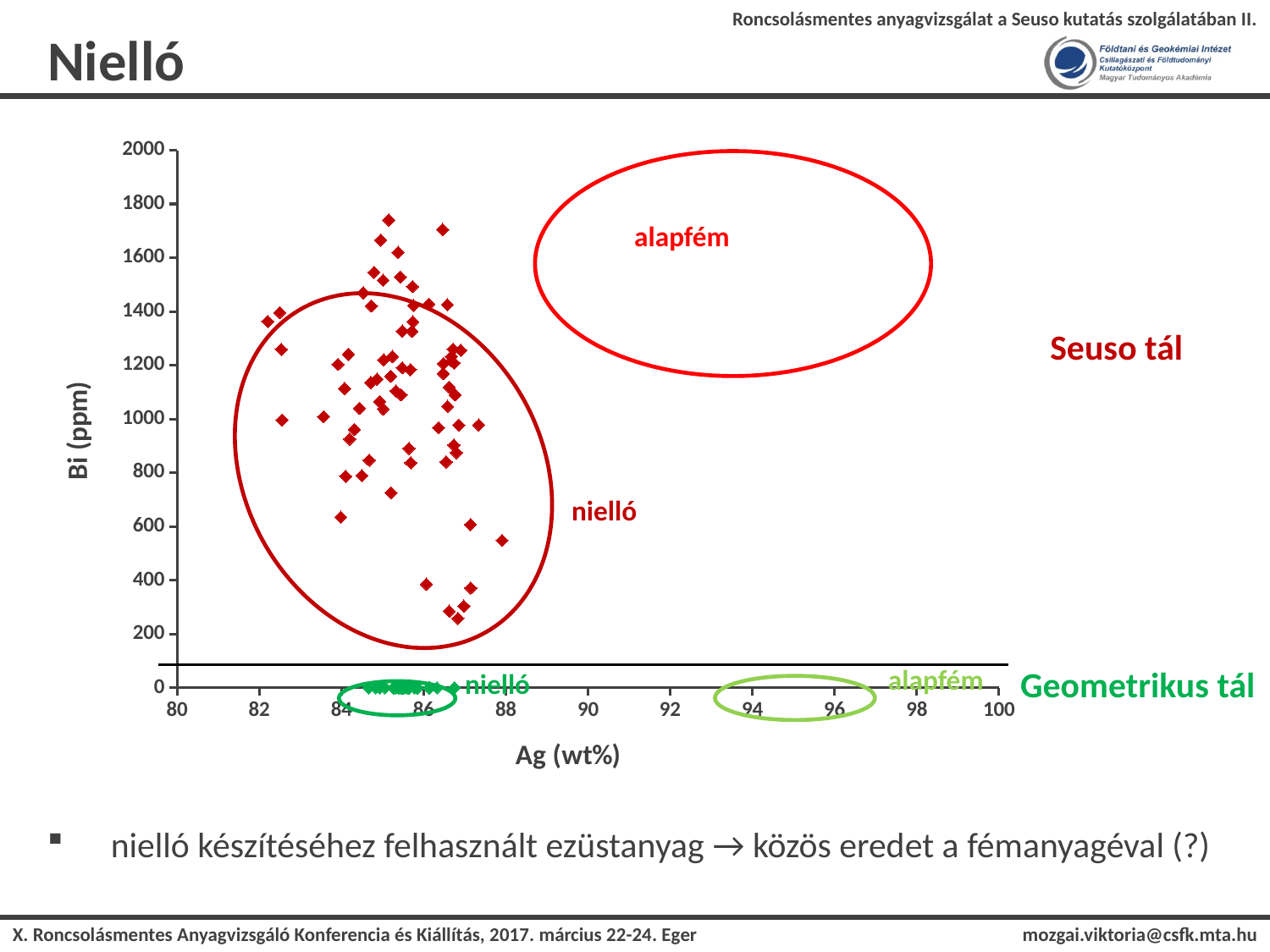
Is the Ag (wt%) value of the leftmost red point greater or less than 84? less What kind of chart is shown on the slide? scatter chart Is the Bi (ppm) value of the highest red Seuso tál point greater or less than 1600? greater Is the Bi (ppm) value of the lowest red Seuso tál point greater or less than 400? less What is the label of the x axis of the chart? Ag (wt%) Which group has higher Bi (ppm) values, the Seuso tál points or the Geometrikus tál points? Seuso tál What is the label of the y axis of the chart? Bi (ppm)